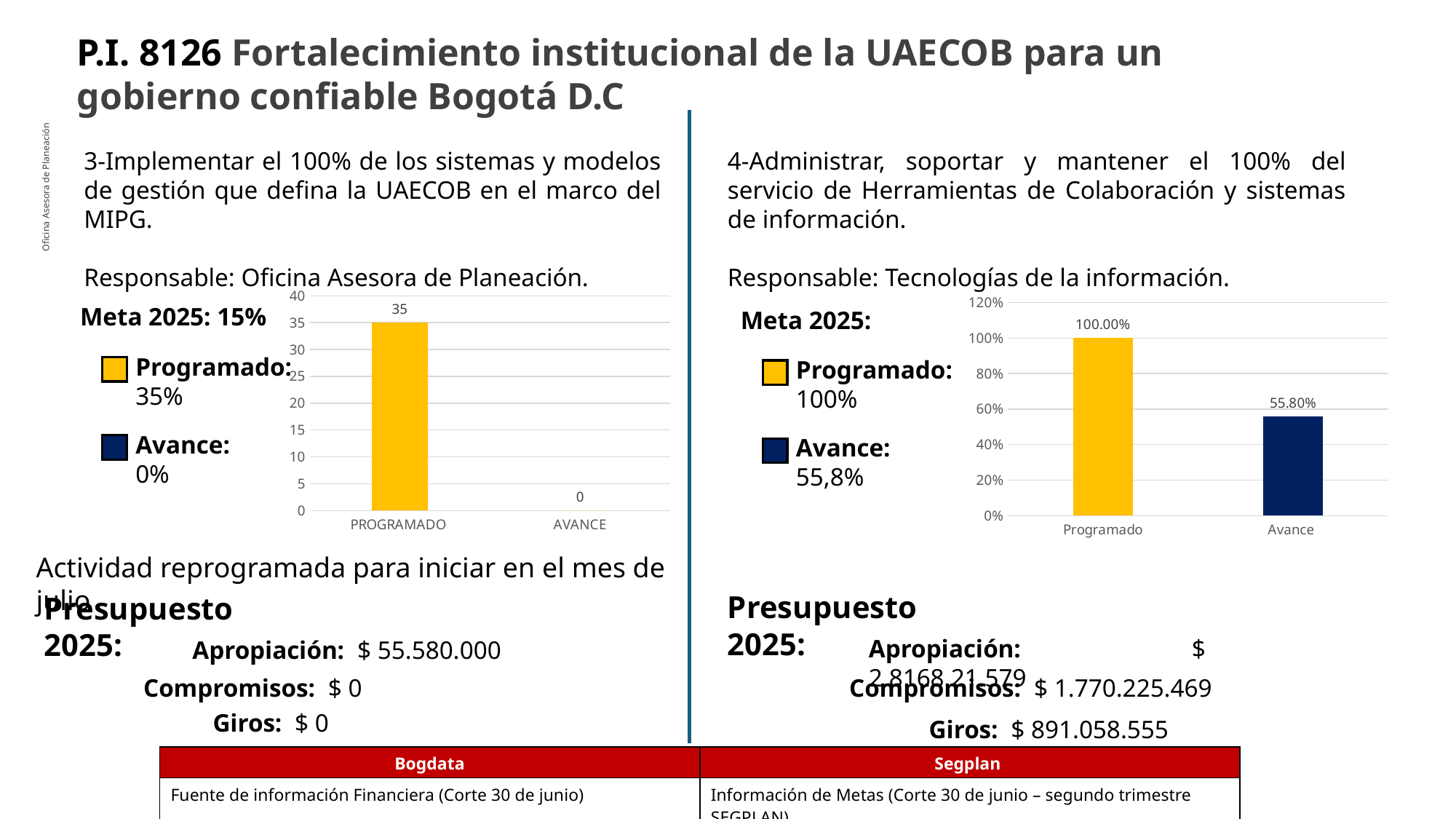
On the left chart, how many categories are shown on the x axis? 2 On the right chart, is the value for Avance greater or less than 60%? less On the right chart, what is the value for Programado? 100.00% On the right chart, which category has the lowest value? Avance On the right chart, what colour is the Avance bar? dark blue What kind of chart is the left chart? bar chart On the left chart, what is the value for PROGRAMADO? 35 On the left chart, what is the difference between PROGRAMADO and AVANCE? 35 On the right chart, what is the value for Avance? 55.80% On the right chart, what is the difference between Programado and Avance? 44.20% On the left chart, which category has the highest value? PROGRAMADO On the left chart, what is the value for AVANCE? 0